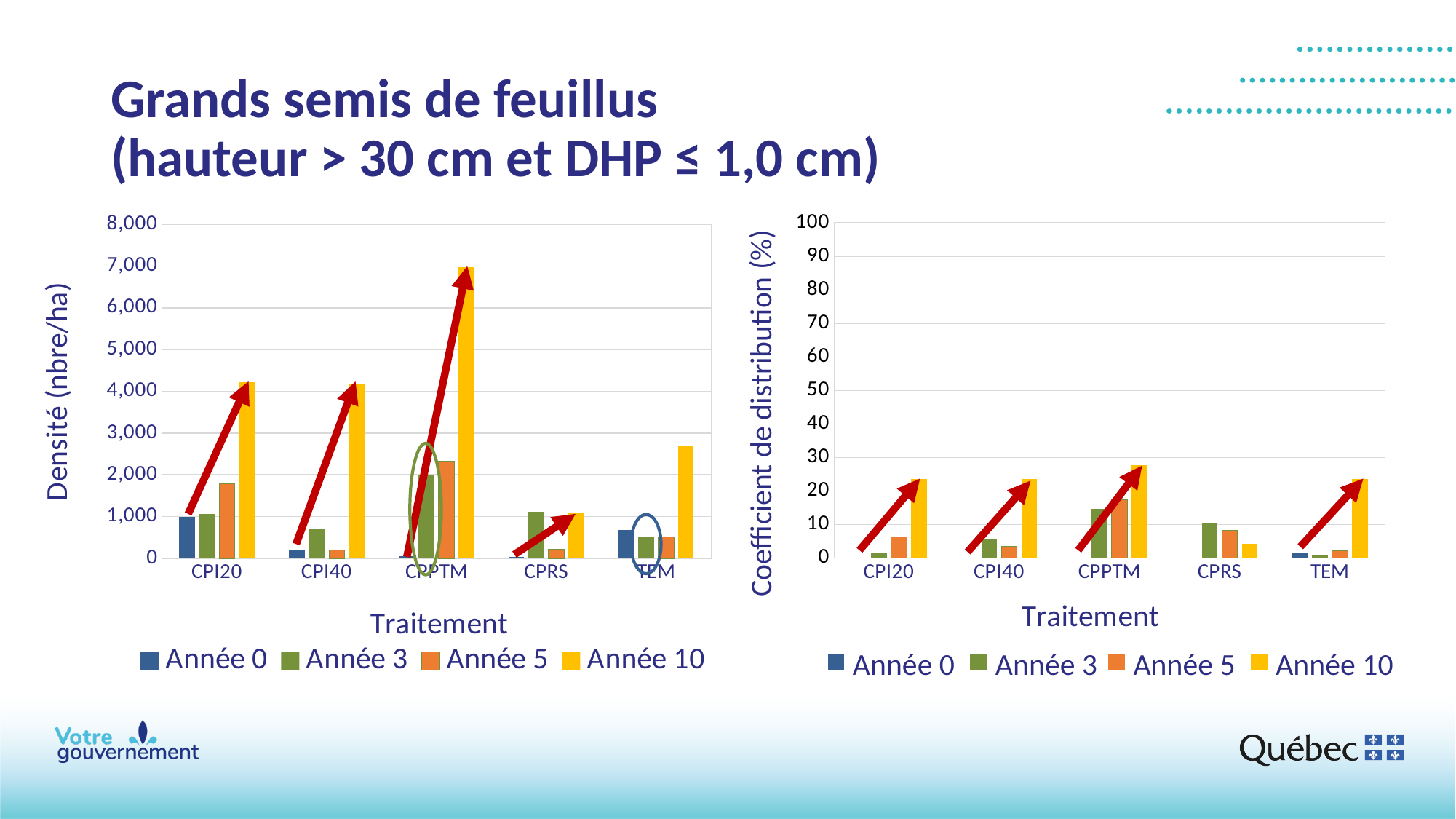
What kind of chart is the left chart (Densité)? bar chart In the left chart (Densité), is the Année 10 value for TEM greater or less than 2,000? greater In the left chart (Densité), which treatment has the highest Année 10 value? CPPTM What is the y-axis label of the right chart? Coefficient de distribution (%) In the right chart (Coefficient de distribution), which is larger for CPRS: Année 3 or Année 10? Année 3 How many treatment categories are shown on the x axis of the right chart (Coefficient de distribution)? 5 How many series does the legend of the left chart (Densité) list? 4 In the left chart (Densité), do the values for CPPTM rise or fall from Année 0 to Année 10? rise In the right chart (Coefficient de distribution), which treatment has the highest Année 10 value? CPPTM In the left chart (Densité), which treatment has the lowest Année 10 value? CPRS In the left chart (Densité), is the Année 10 value for CPPTM greater or less than 6,000? greater In the right chart (Coefficient de distribution), is the Année 10 value for CPRS greater or less than 10? less